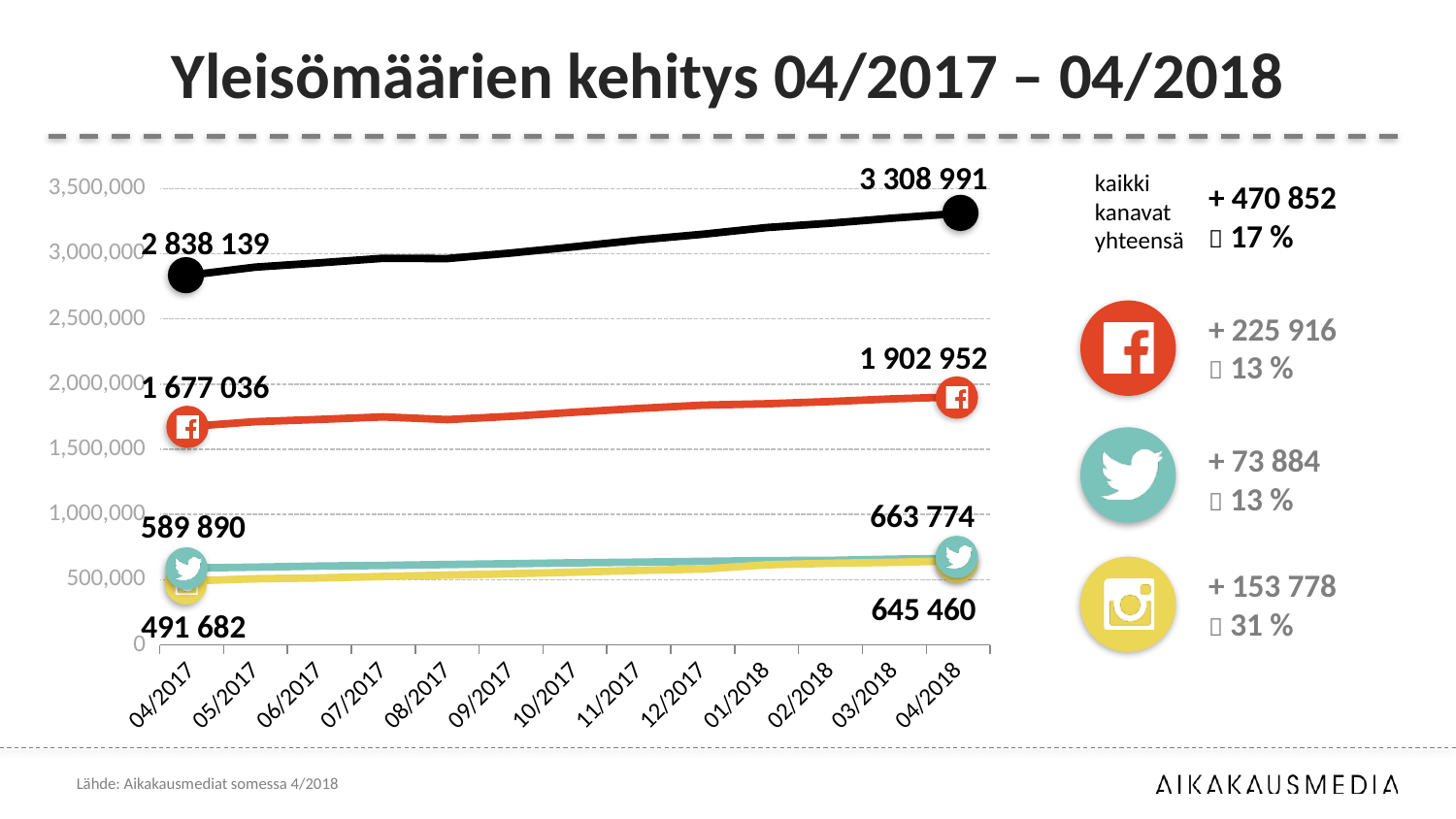
Which is larger at 04/2018: the Twitter value or the Instagram value? The Twitter value Is the Facebook value at 04/2018 greater or less than 2,000,000? less What is the value of the Facebook line at 04/2017? 1 677 036 What is the difference between the Facebook value at 04/2018 and at 04/2017? 225 916 Which line has the highest value at 04/2018? The black (all channels) line What kind of chart is shown on the slide? Line chart What is the value of the black (all channels) line at 04/2018? 3 308 991 How many months are shown on the x axis? 13 What is the value of the Twitter line at 04/2018? 663 774 Which line has the lowest value at 04/2017? The Instagram line By how much did the black (all channels) line increase from 04/2017 to 04/2018? 470 852 What is the value of the Instagram line at 04/2017? 491 682